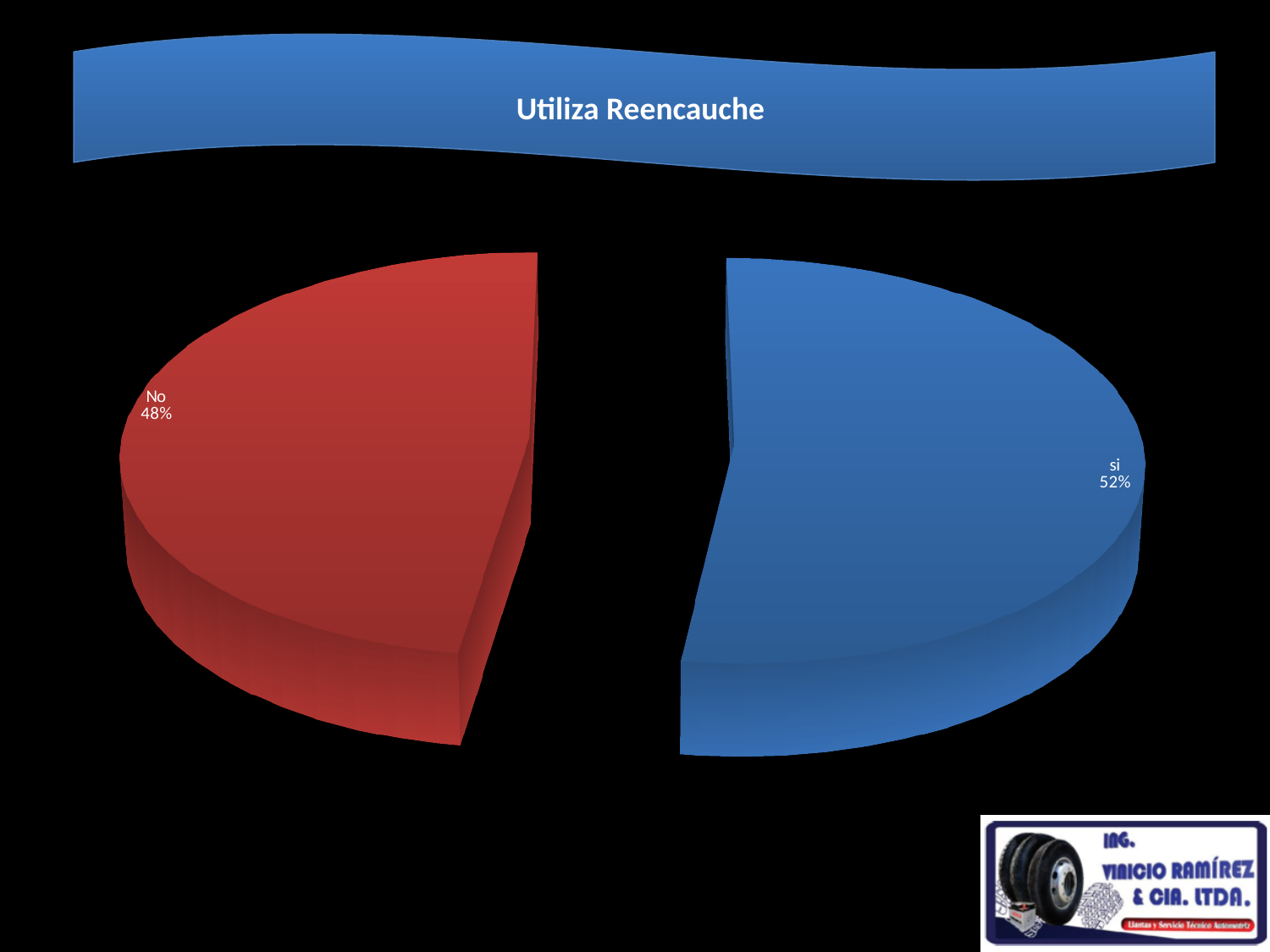
What colour is the "si" slice? Blue What is the title shown above the chart? Utiliza Reencauche Is the share for "No" greater or less than 50%? less How many slices does the pie chart have? 2 What share of the pie does the "No" slice represent? 48% What share of the pie does the "si" slice represent? 52% Which slice is the largest in the pie chart? si Which slice is the smallest in the pie chart? No What is the difference in percentage points between the "si" and "No" slices? 4% Which is larger, the "si" slice or the "No" slice? si What kind of chart is shown on the slide? Pie chart